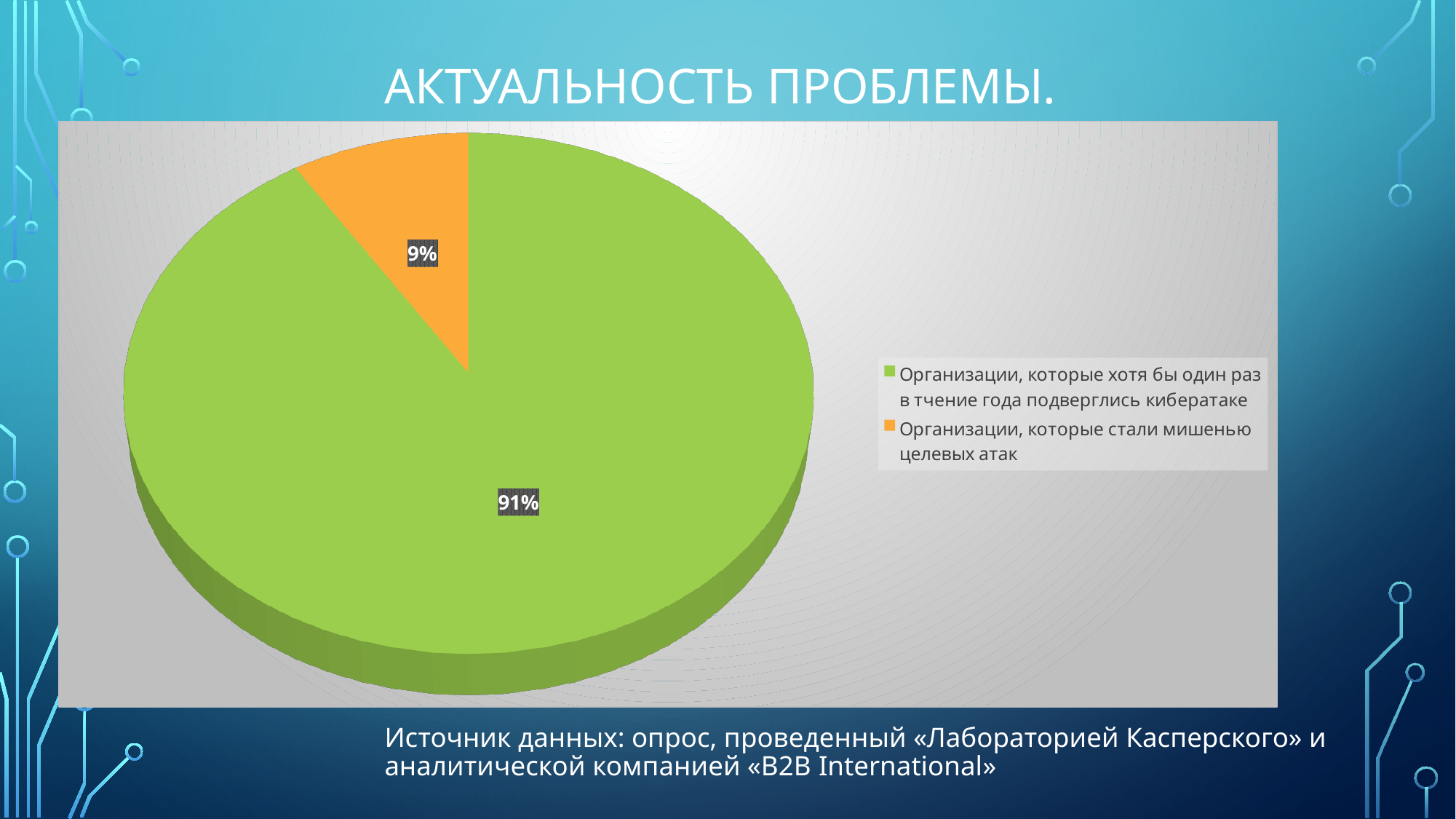
What colour is the slice for organizations that became the target of targeted attacks? orange What is the difference in percentage points between the two slices of the pie? 82 Which category has the smallest slice of the pie? Организации, которые стали мишенью целевых атак What percentage is shown for organizations that were subjected to a cyberattack at least once during the year (Организации, которые хотя бы один раз в тчение года подверглись кибератаке)? 91% What kind of chart is shown on the slide? pie chart What is the title of the slide containing the chart? АКТУАЛЬНОСТЬ ПРОБЛЕМЫ. Which is larger: the share of organizations subjected to a cyberattake at least once during the year, or the share of organizations that became the target of targeted attacks? Организации, которые хотя бы один раз в тчение года подверглись кибератаке How many slices does the pie chart have? 2 How many entries does the legend list? 2 What percentage is shown for organizations that became the target of targeted attacks (Организации, которые стали мишенью целевых атак)? 9% Which category has the largest slice of the pie? Организации, которые хотя бы один раз в тчение года подверглись кибератаке